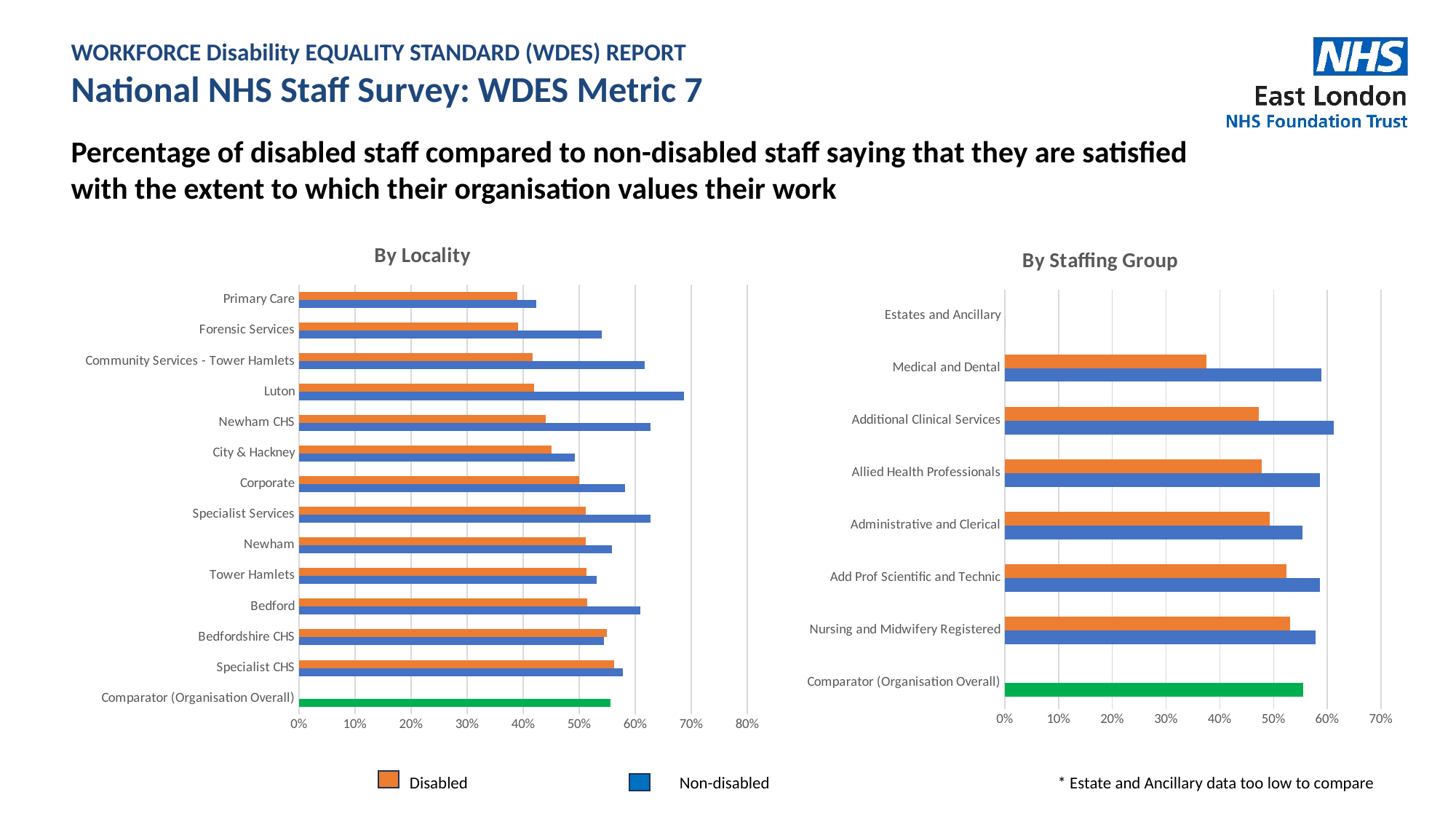
In the 'By Staffing Group' chart, is the Non-disabled value for Medical and Dental greater or less than 50%? greater In the 'By Staffing Group' chart, is the Disabled value for Medical and Dental greater or less than 40%? less In the 'By Locality' chart, is the Non-disabled value for Primary Care greater or less than 50%? less In the 'By Locality' chart, which is larger for Luton: the Disabled value or the Non-disabled value? Non-disabled According to the footnote, which staffing group's data was too low to compare? Estate and Ancillary How many series does the legend at the bottom of the slide list? 2 In the 'By Staffing Group' chart, which staffing group has the lowest Disabled value? Medical and Dental In the 'By Locality' chart, which locality has the highest Non-disabled value? Luton How many categories are listed on the 'By Locality' chart? 14 What kind of chart is the 'By Locality' chart? bar chart In the 'By Locality' chart, which locality has the lowest Non-disabled value? Primary Care